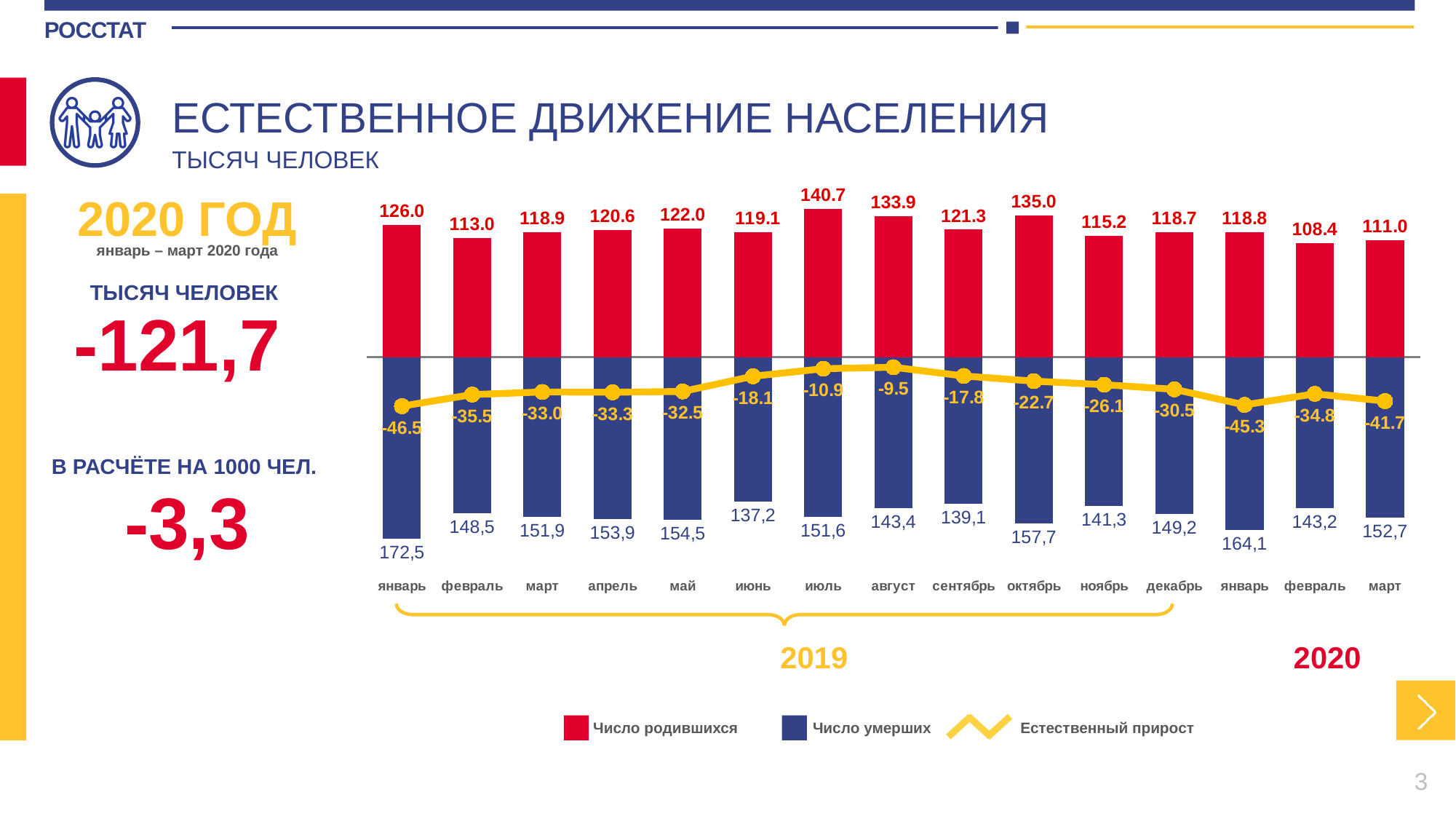
In which month is Число умерших highest? январь 2019 In which month is Число умерших lowest? июнь 2019 What kind of chart is shown on the slide? Combined bar and line chart In which month is Число родившихся highest? июль 2019 What is the difference between Число родившихся in июль 2019 and in февраль 2020? 32.3 Which is larger: Число умерших in октябрь 2019 or in ноябрь 2019? октябрь 2019 What is the value of Число умерших for январь 2020? 164,1 What is the value of Естественный прирост for август 2019? -9.5 How many series does the legend list? 3 In which month is Число родившихся lowest? февраль 2020 What is the value of Число родившихся for июль 2019? 140.7 How many months are shown on the x axis of the chart? 15